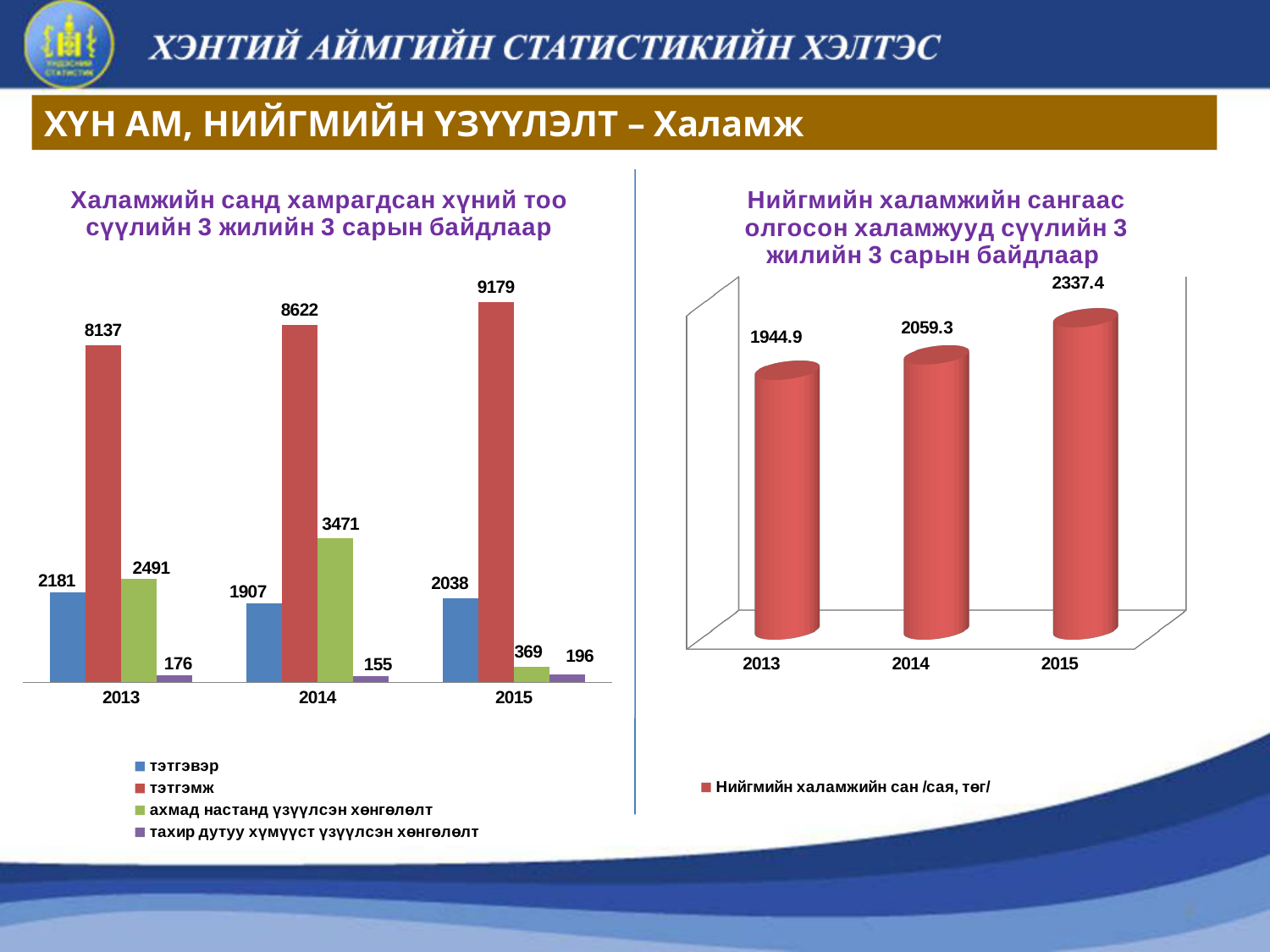
What kind of chart is the left chart? Bar chart In the right chart, what is the difference between the 2015 and 2013 values? 392.5 In the right chart, do the values rise or fall from 2013 to 2015? Rise In the left chart, what is the value of ахмад настанд үзүүлсэн хөнгөлөлт for 2015? 369 In the right chart, what is the value for 2014? 2059.3 In the left chart, what is the difference between тэтгэмж in 2015 and тэтгэмж in 2013? 1042 In the left chart, which year has the highest value for тэтгэмж? 2015 How many years are shown on the x axis of the right chart? 3 How many series does the legend of the left chart list? 4 In the left chart, what is the value of тэтгэмж for 2014? 8622 In the left chart, which year has the lowest value for тахир дутуу хүмүүст үзүүлсэн хөнгөлөлт? 2014 In the left chart, which is larger: тэтгэвэр in 2013 or тэтгэвэр in 2015? тэтгэвэр in 2013